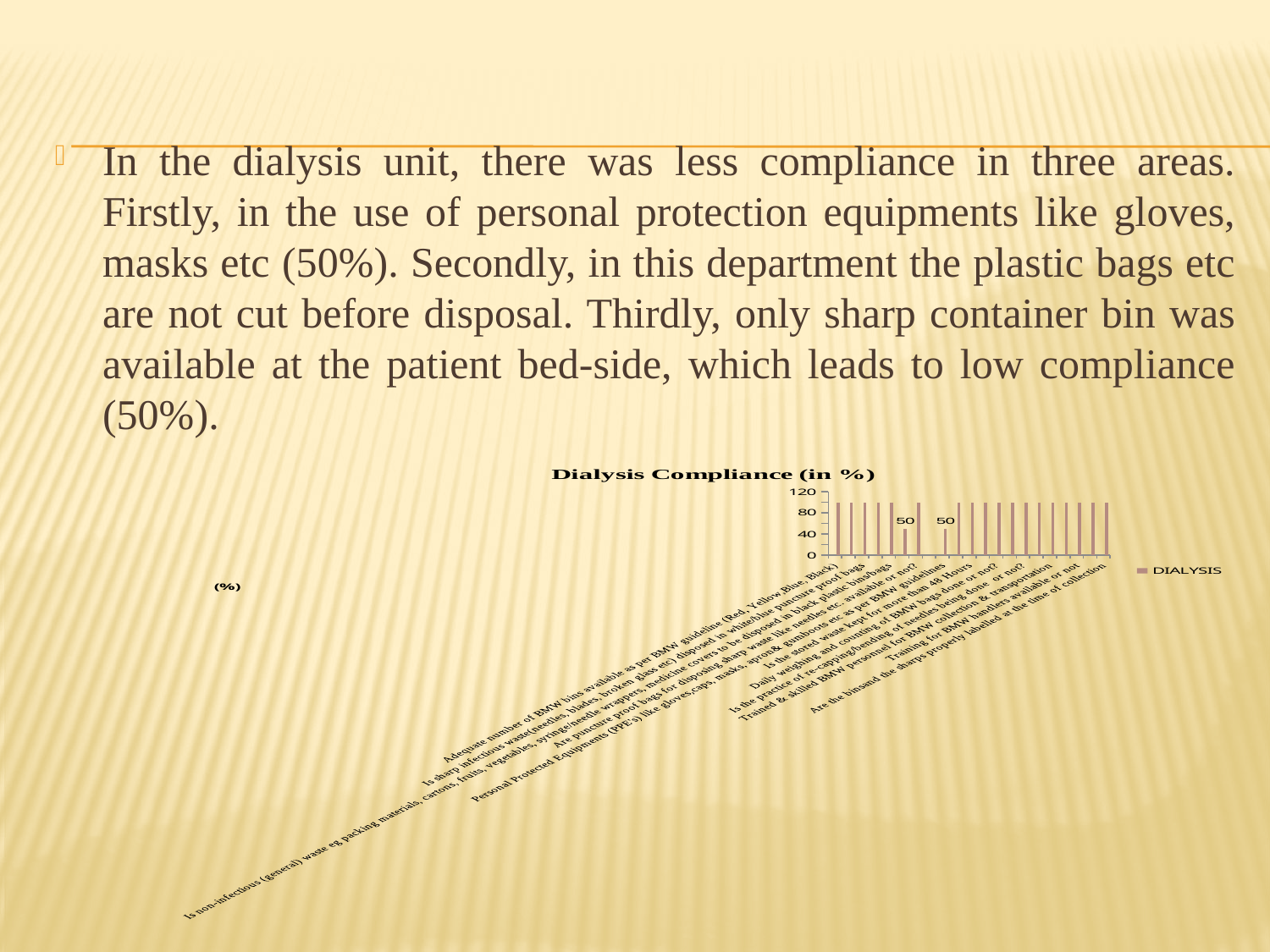
What is the highest value shown on the chart's vertical axis? 120 What series name appears in the chart legend? DIALYSIS Are the bars labelled 50 greater or less than 80? less Is the value of the last (rightmost) bar in the chart greater or less than 80? greater What is the lowest value labelled on any bar in the chart? 50 What is the title of the chart? Dialysis Compliance (in %) What kind of chart is shown on the slide? bar chart Is the value of the first (leftmost) bar in the chart greater or less than 80? greater How many series does the chart legend list? 1 How many bars in the chart carry the data label 50? 2 Which is larger: the leftmost bar or a bar labelled 50? the leftmost bar